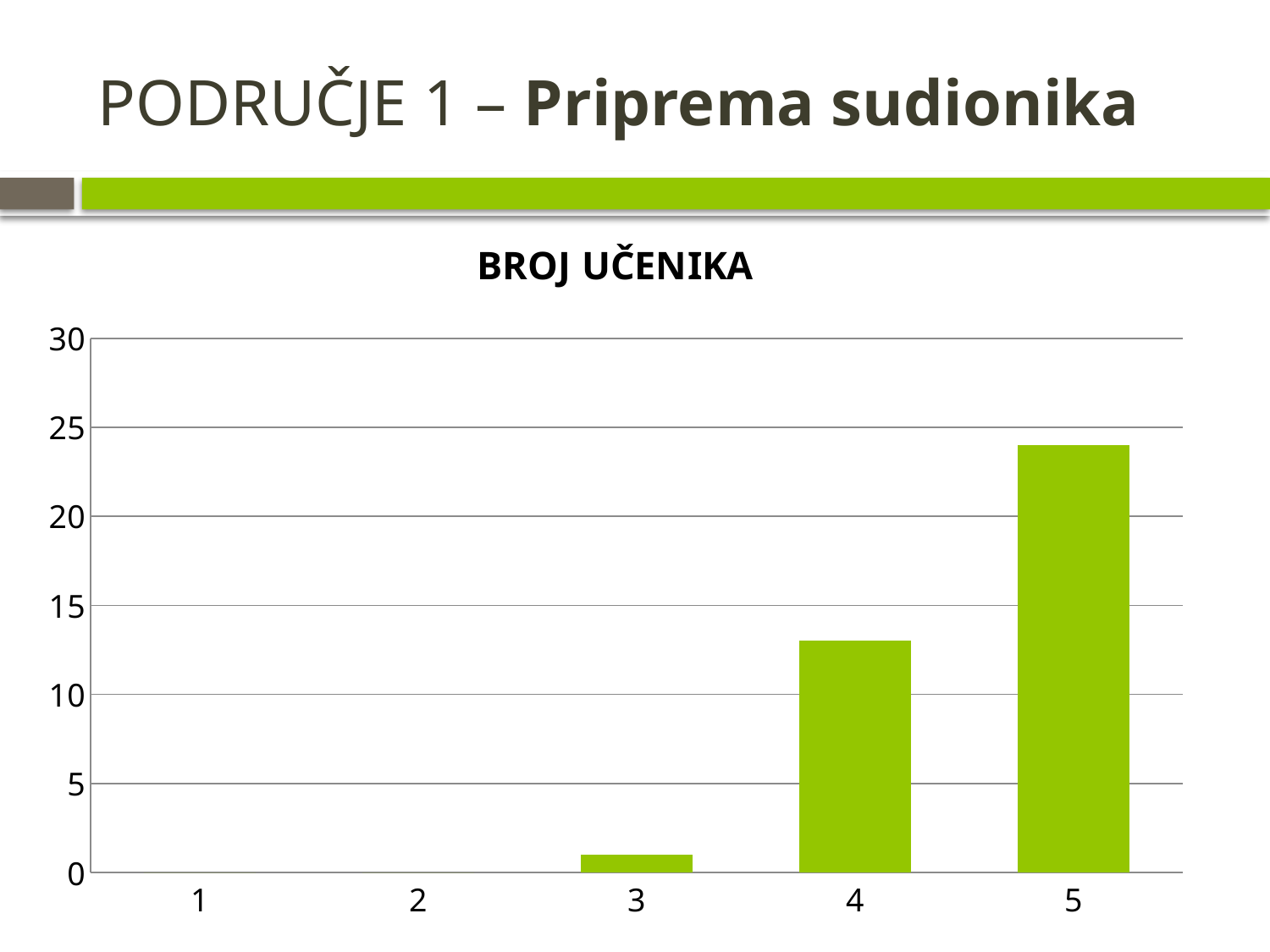
Which has a larger value, category 3 or category 4? 4 Is the value for category 5 greater or less than 20? greater Is the value for category 3 greater or less than 5? less Do the values rise or fall from category 3 to category 5? rise Which has a larger value, category 4 or category 5? 5 Which category has the highest value in the chart? 5 How many categories are shown on the x axis of the chart? 5 What kind of chart is shown on the slide? bar chart Is the value for category 5 greater or less than 25? less What is the title of the chart? BROJ UČENIKA